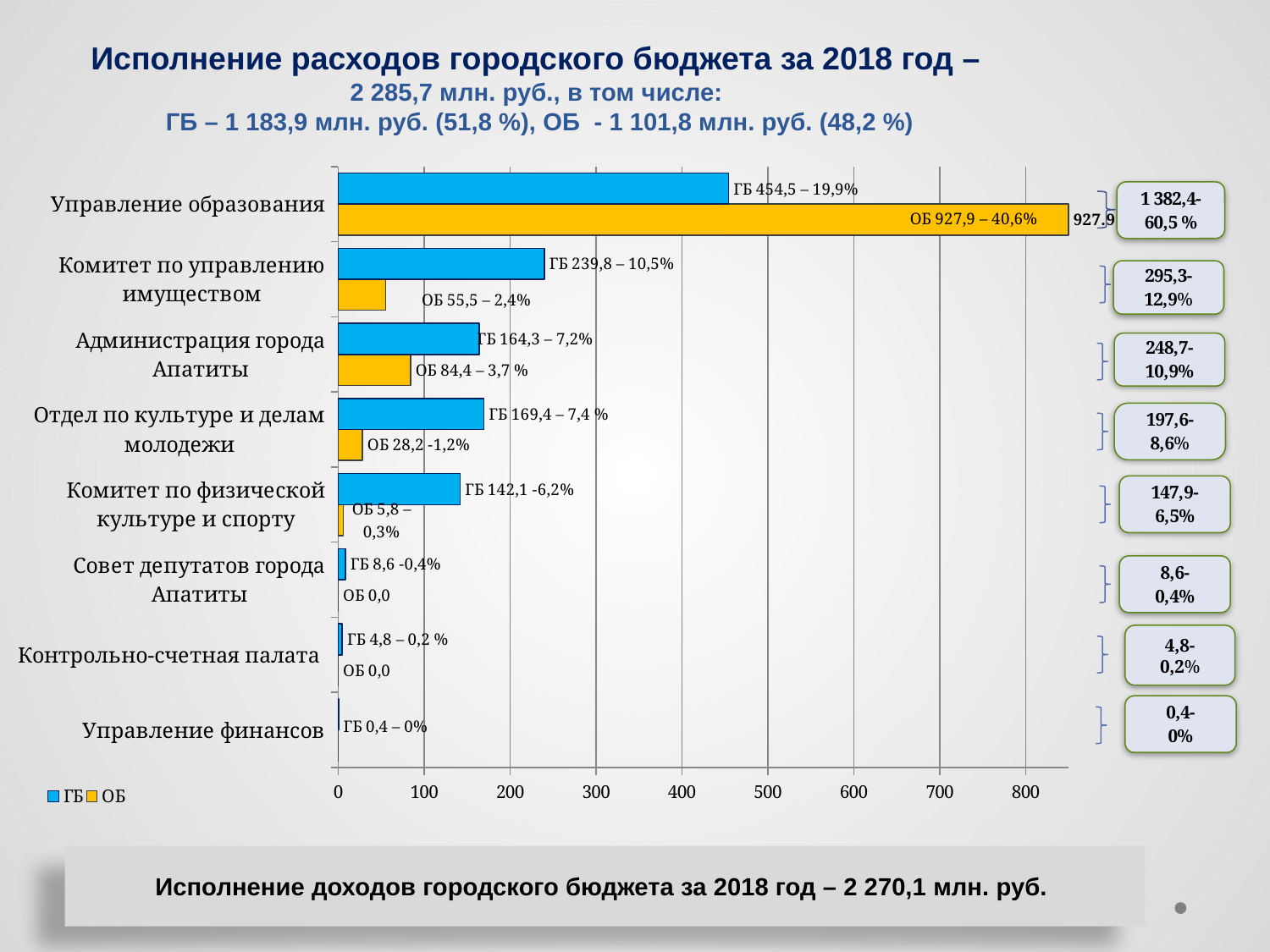
Which is larger for Администрация города Апатиты, the ГБ value or the ОБ value? ГБ What is the difference between the ОБ and ГБ values for Управление образования? 473,4 Is the ОБ value for Управление образования greater or less than 800? greater How many series does the legend list? 2 What is the ОБ value for Комитет по управлению имуществом? 55,5 What is the ГБ value for Комитет по физической культуре и спорту? 142,1 Which category has the highest ОБ value? Управление образования What is the ГБ value for Управление образования? 454,5 Which colour represents the ОБ series in the chart? yellow Which category has the lowest ГБ value? Управление финансов How many categories (organisations) are shown on the chart? 8 What type of chart is shown on the slide? bar chart